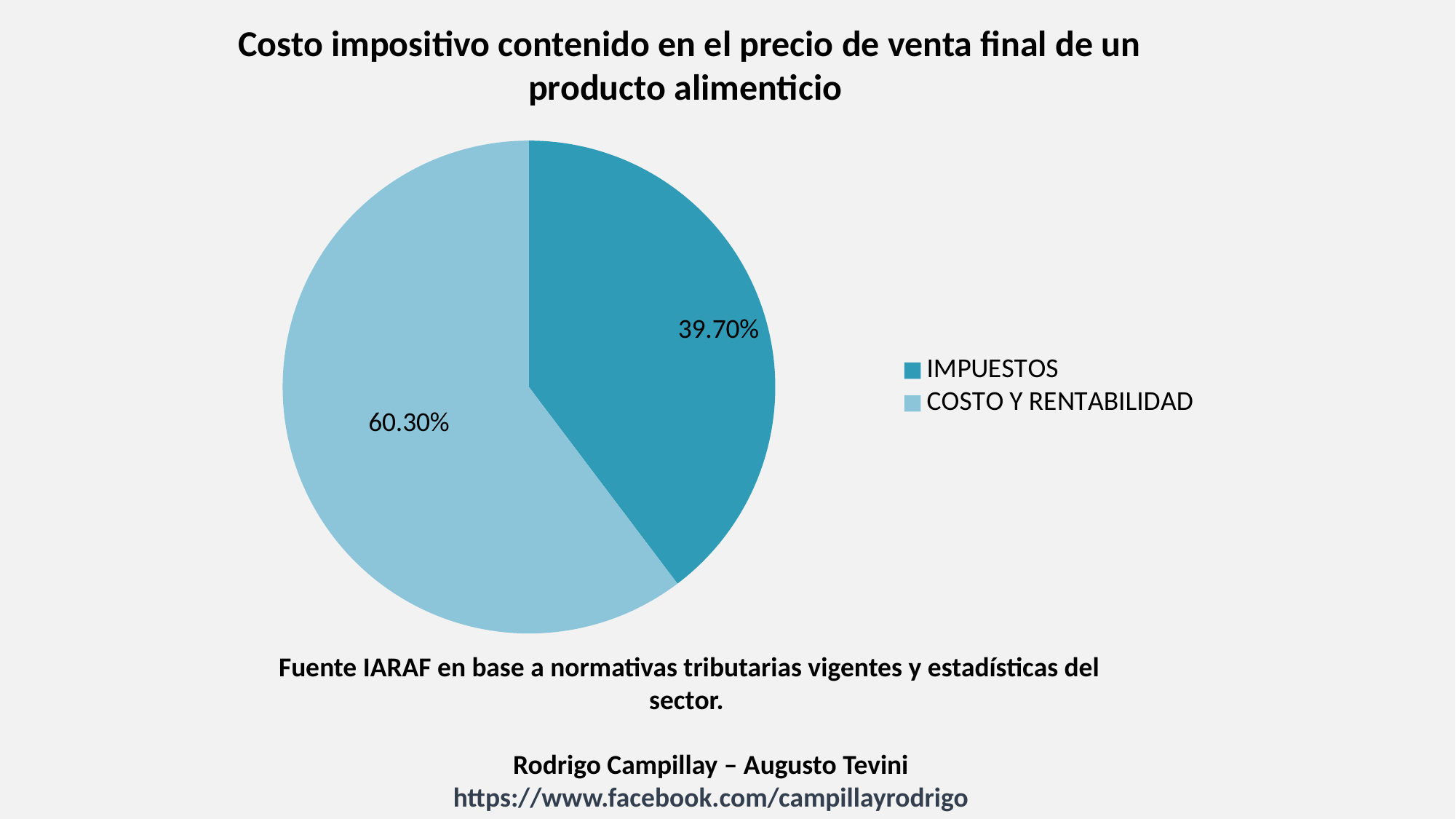
What type of chart is shown on the slide? Pie chart Which is larger, IMPUESTOS or COSTO Y RENTABILIDAD? COSTO Y RENTABILIDAD What is the value shown for COSTO Y RENTABILIDAD? 60.30% Which legend entry is shown in the darker blue colour? IMPUESTOS How many slices does the pie chart have? 2 How many entries does the legend list? 2 What is the value shown for IMPUESTOS? 39.70% What is the difference between the COSTO Y RENTABILIDAD and IMPUESTOS slices? 20.60% What share of the pie does IMPUESTOS represent? 39.70% Which slice is the smallest? IMPUESTOS What is the title of the chart? Costo impositivo contenido en el precio de venta final de un producto alimenticio Which slice is the largest? COSTO Y RENTABILIDAD